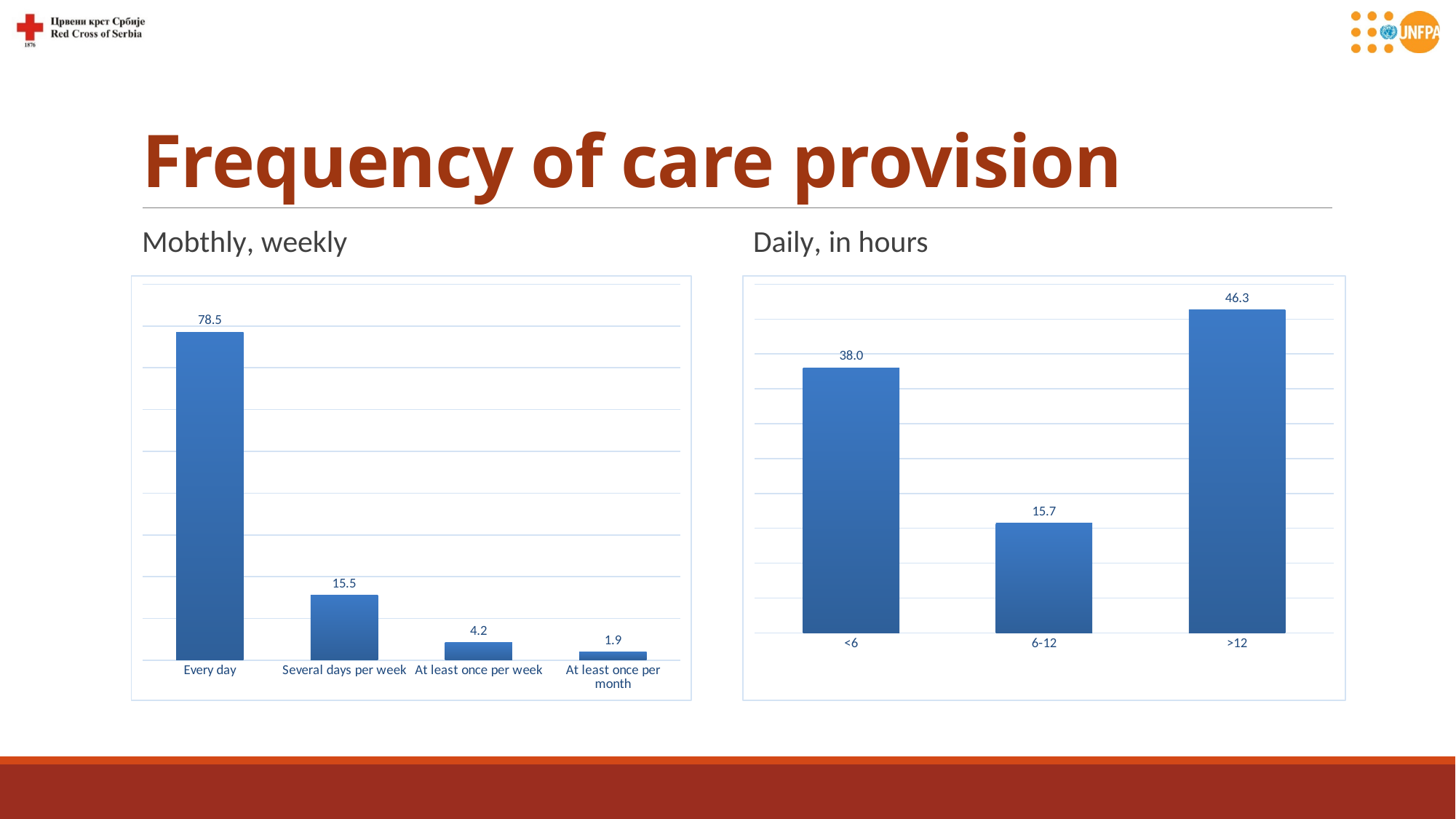
In the right chart (Daily, in hours), what is the value for >12? 46.3 In the right chart (Daily, in hours), what is the difference between >12 and <6? 8.3 In the left chart (Monthly, weekly), which category has the lowest value? At least once per month In the left chart (Monthly, weekly), what is the difference between Every day and Several days per week? 63.0 What kind of chart is the right chart (Daily, in hours)? Bar chart In the right chart (Daily, in hours), which category has the highest value? >12 In the right chart (Daily, in hours), what is the value for 6-12? 15.7 In the left chart (Monthly, weekly), how many categories are shown? 4 In the left chart (Monthly, weekly), what is the value for Several days per week? 15.5 In the right chart (Daily, in hours), which is larger, <6 or 6-12? <6 In the left chart (Monthly, weekly), what is the value for Every day? 78.5 In the left chart (Monthly, weekly), what is the value for At least once per month? 1.9